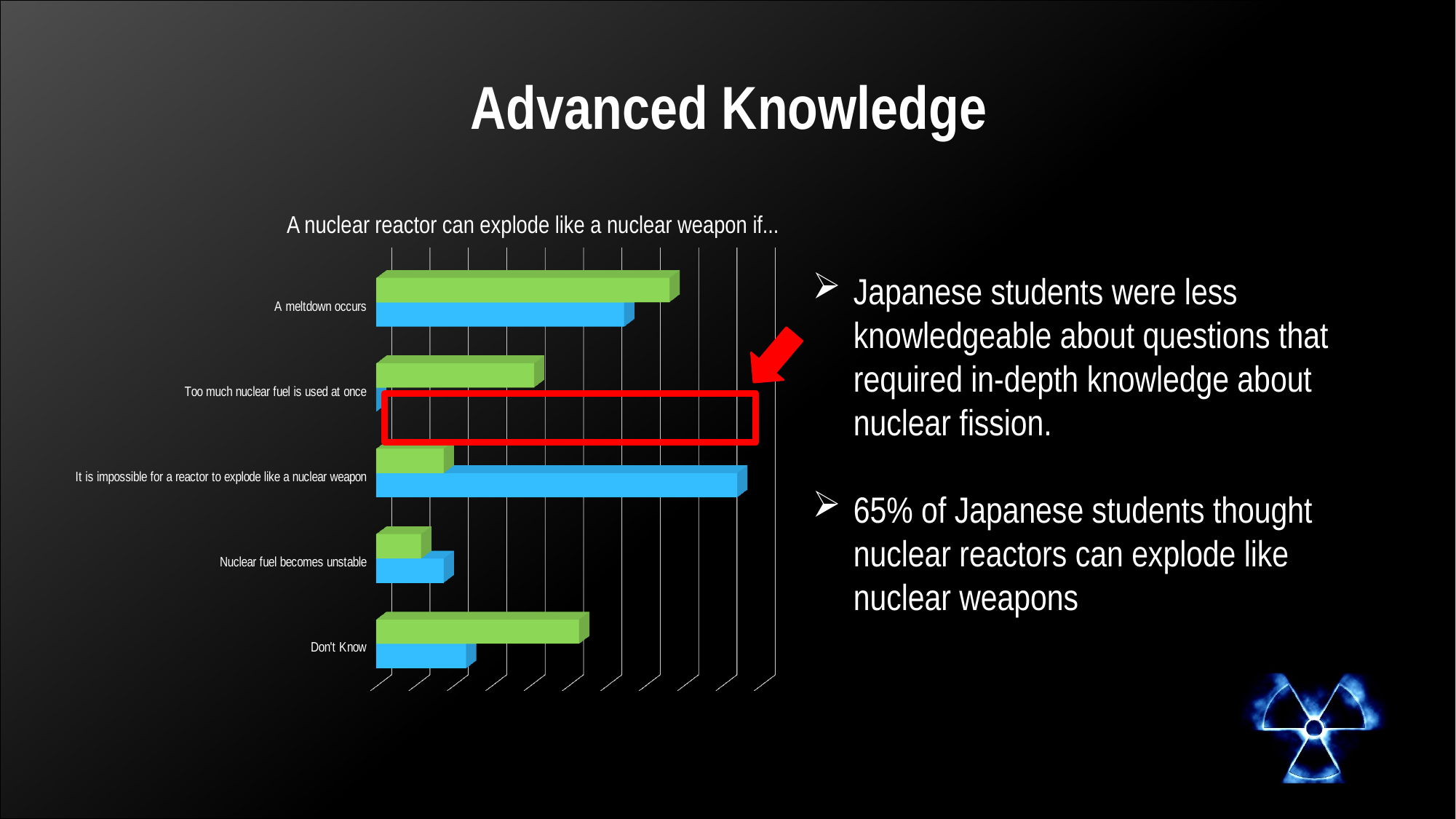
What kind of chart is shown on the slide? bar chart Which category has the longest green bar? A meltdown occurs Is the green bar for 'Don't Know' longer or shorter than the green bar for 'Nuclear fuel becomes unstable'? longer How many categories are listed on the chart's vertical axis? 5 Which category has the shortest green bar? Nuclear fuel becomes unstable How many bar colours (series) are plotted for each category in the chart? 2 For the category 'A meltdown occurs', which bar is longer, the green one or the blue one? green For the category 'Don't Know', which bar is longer, the green one or the blue one? green Which category has the longest blue bar? It is impossible for a reactor to explode like a nuclear weapon Which category is highlighted with a red box on the chart? Too much nuclear fuel is used at once What is the title of the chart? A nuclear reactor can explode like a nuclear weapon if...